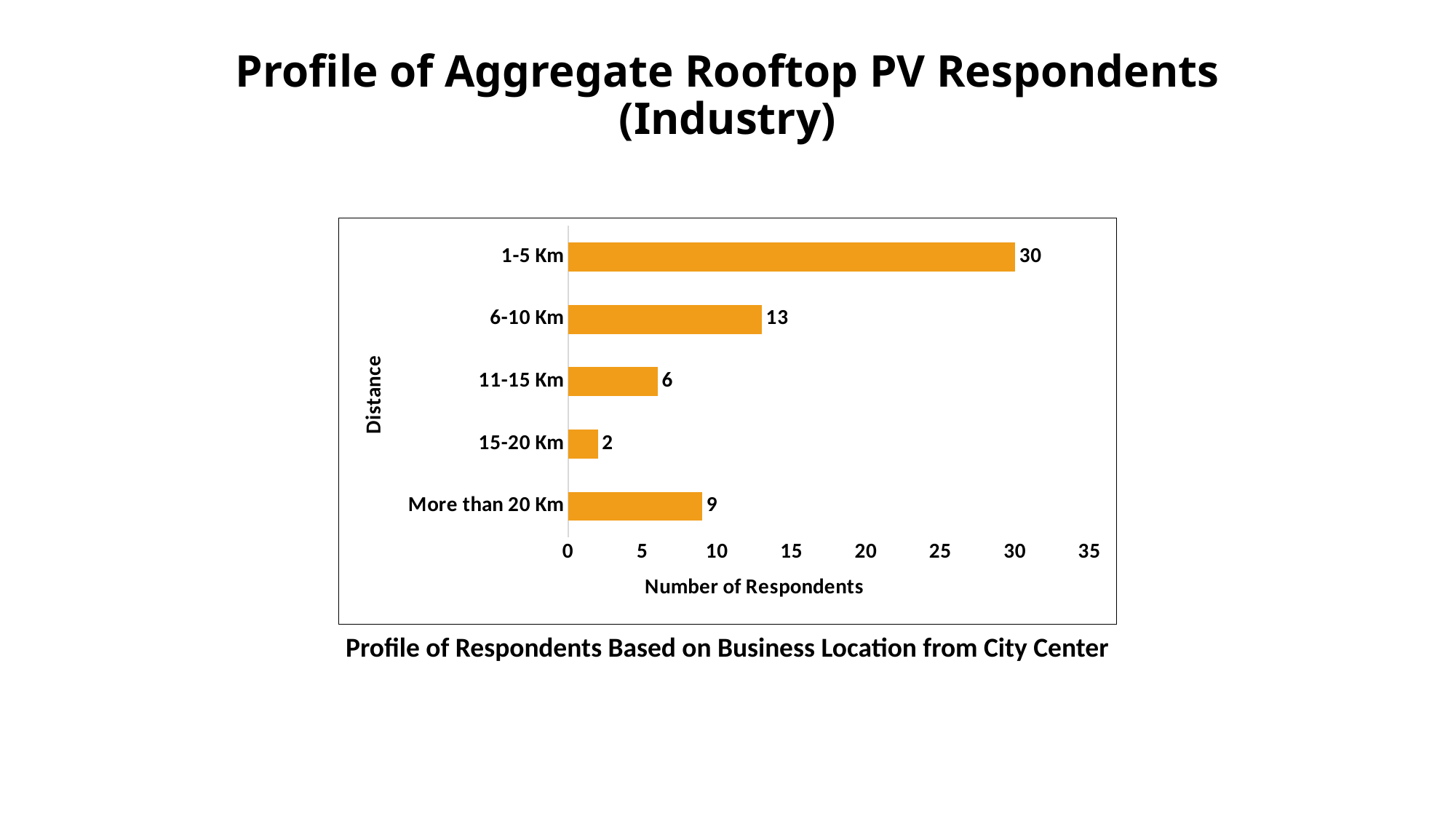
What type of chart is shown on the slide? Bar chart What is the number of respondents for 6-10 Km? 13 Which distance category has the lowest number of respondents? 15-20 Km Which distance category has the highest number of respondents? 1-5 Km Is the value for 6-10 Km greater or less than 10? greater What is the label of the horizontal axis? Number of Respondents How many respondents are in the 1-5 Km category? 30 What is the difference in respondents between More than 20 Km and 11-15 Km? 3 What is the difference in respondents between 1-5 Km and 6-10 Km? 17 Which has more respondents, 11-15 Km or More than 20 Km? More than 20 Km How many distance categories are shown in the chart? 5 What is the number of respondents for More than 20 Km? 9